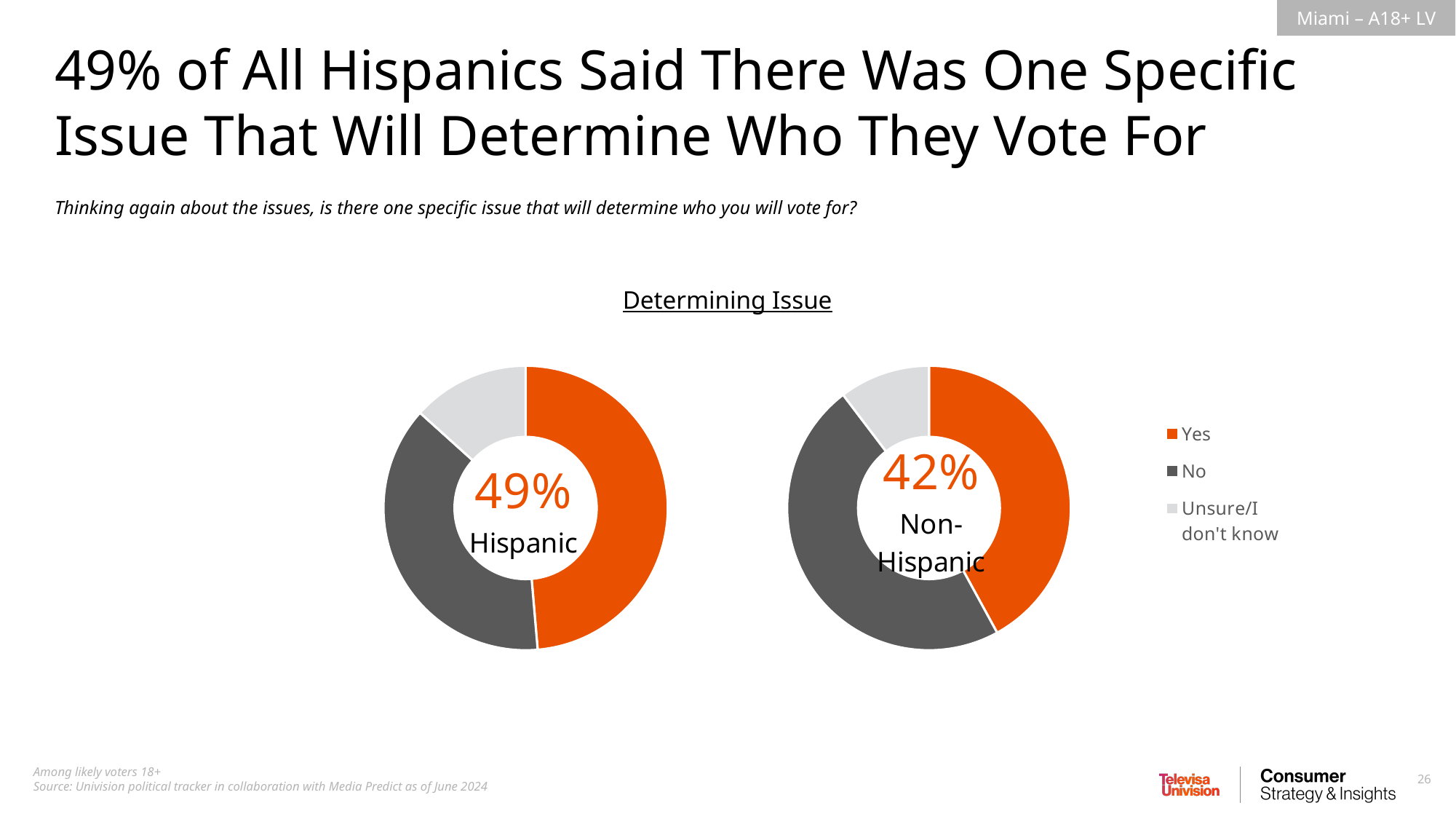
In the Non-Hispanic donut chart, what percentage said Yes? 42% How many entries does the legend list? 3 Which colour represents the Yes response in the charts? Orange What is the title shown above the two donut charts? Determining Issue What is the difference between the Hispanic Yes share and the Non-Hispanic Yes share? 7 percentage points Which group has the larger Yes share, Hispanic or Non-Hispanic? Hispanic What kind of chart is used to show the Determining Issue data? Pie (donut) chart How many slices does the Hispanic donut chart have? 3 In the Hispanic donut chart, which response is the largest slice? Yes In the Hispanic donut chart, which response is the smallest slice? Unsure/I don't know In the Hispanic donut chart, what percentage said Yes? 49% In the Non-Hispanic donut chart, which response is the smallest slice? Unsure/I don't know